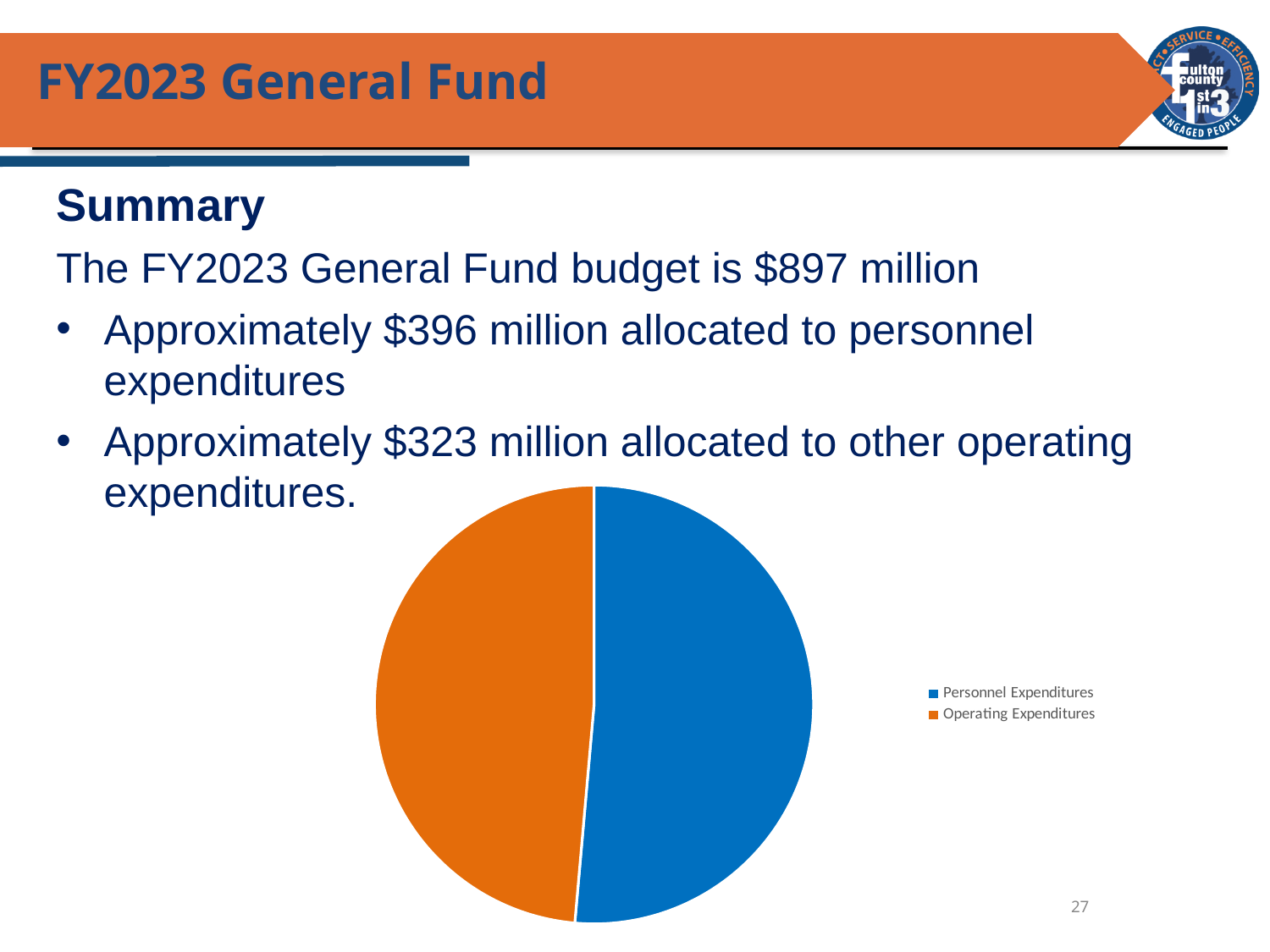
What kind of chart is shown on the slide? pie chart How many entries does the legend of the pie chart list? 2 Which category does the blue slice of the pie chart represent? Personnel Expenditures Which category has the smallest slice in the pie chart? Operating Expenditures Which slice of the pie chart is larger, Personnel Expenditures or Operating Expenditures? Personnel Expenditures How many slices does the pie chart have? 2 Which category does the orange slice of the pie chart represent? Operating Expenditures